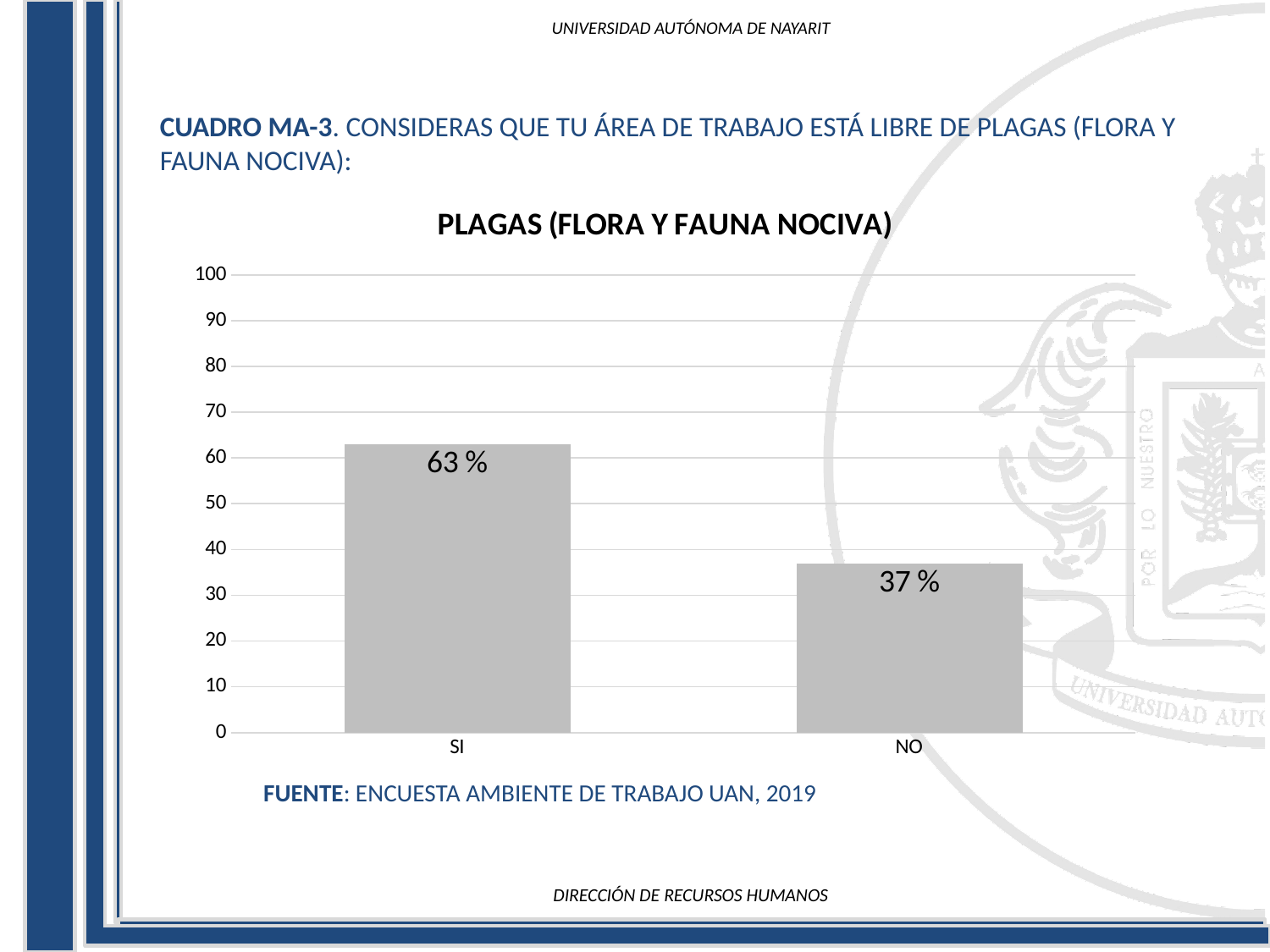
What is the value for NO? 37 % Which category has the lowest value? NO What kind of chart is shown? bar chart What is the difference between the values for SI and NO? 26 % What is the maximum value shown on the y axis? 100 What is the title of the chart? PLAGAS (FLORA Y FAUNA NOCIVA) Is the value for NO greater or less than 40? less Is the value for SI greater or less than 60? greater Which is larger, the value for SI or the value for NO? SI How many categories are shown on the x axis? 2 Which category has the highest value? SI What is the value for SI? 63 %